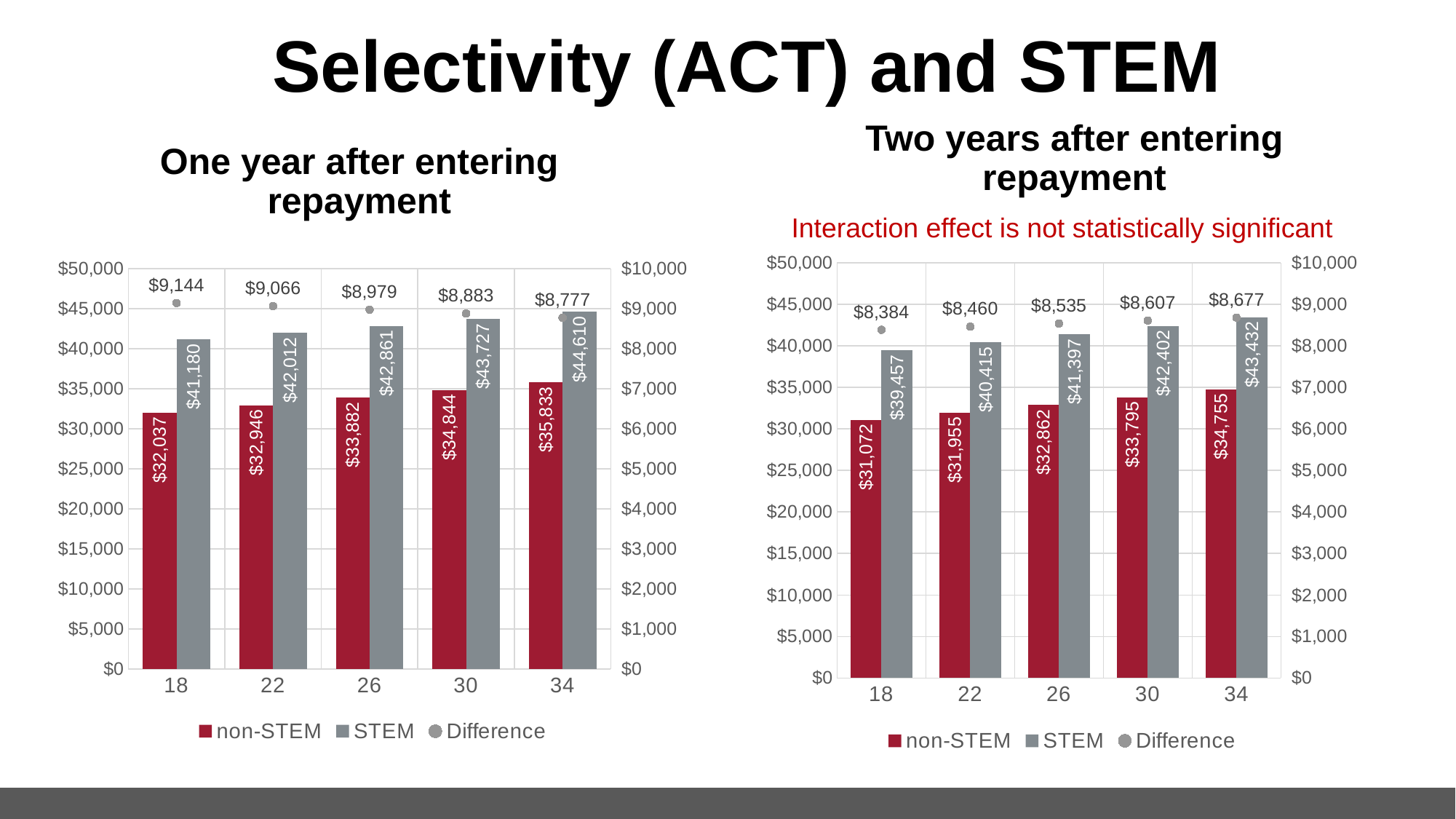
In the 'One year after entering repayment' chart, which ACT category has the lowest Difference value? 34 In the 'Two years after entering repayment' chart, do the Difference values rise or fall as ACT increases from 18 to 34? rise In the 'One year after entering repayment' chart, what is the STEM value at ACT 34? $44,610 In the 'One year after entering repayment' chart, what is the non-STEM value at ACT 26? $33,882 In the 'Two years after entering repayment' chart, what is the STEM value at ACT 22? $40,415 In the 'One year after entering repayment' chart, what is the Difference value at ACT 18? $9,144 In the 'Two years after entering repayment' chart, what is the non-STEM value at ACT 30? $33,795 In the 'One year after entering repayment' chart, what is the difference between the STEM and non-STEM values at ACT 18? $9,143 In the 'Two years after entering repayment' chart, which ACT category has the highest Difference value? 34 How many ACT categories are shown on the x axis of the 'One year after entering repayment' chart? 5 How many series does the legend of the 'Two years after entering repayment' chart list? 3 In the 'One year after entering repayment' chart, do the Difference values rise or fall as ACT increases from 18 to 34? fall